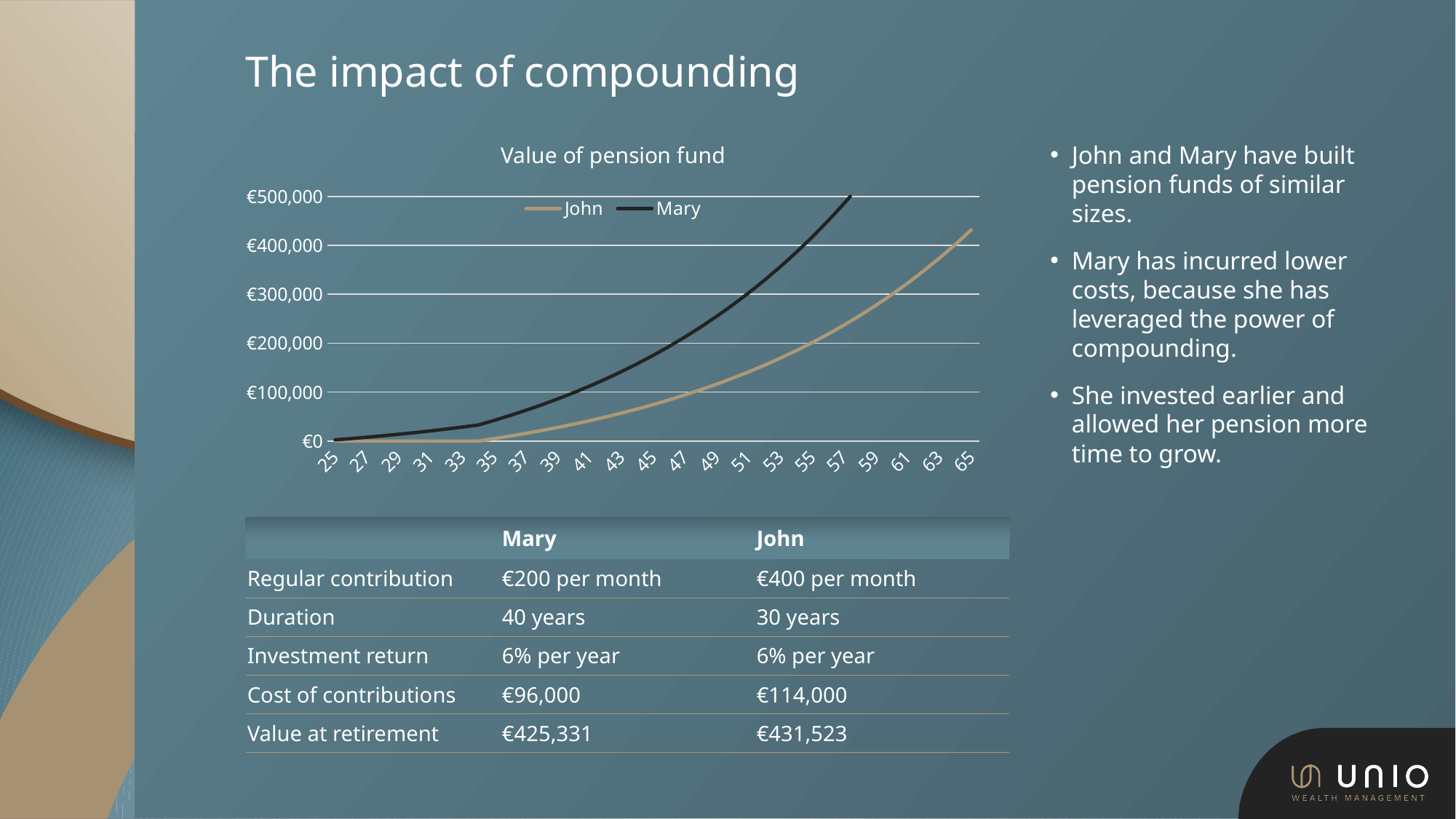
Do the values for Mary rise or fall as age increases along the x axis? rise Which series stays at €0 for the first several years on the chart? John Which series is drawn in black on the chart? Mary Is the value for John at age 65 greater or less than €400,000? greater At age 55, which series has the higher value, John or Mary? Mary Is the value for Mary at age 35 greater or less than €100,000? less Is the value for John at age 45 greater or less than €100,000? less How many age labels are shown on the x axis of the chart? 21 What kind of chart is shown on the slide? line chart What is the title of the chart? Value of pension fund How many series does the chart legend list? 2